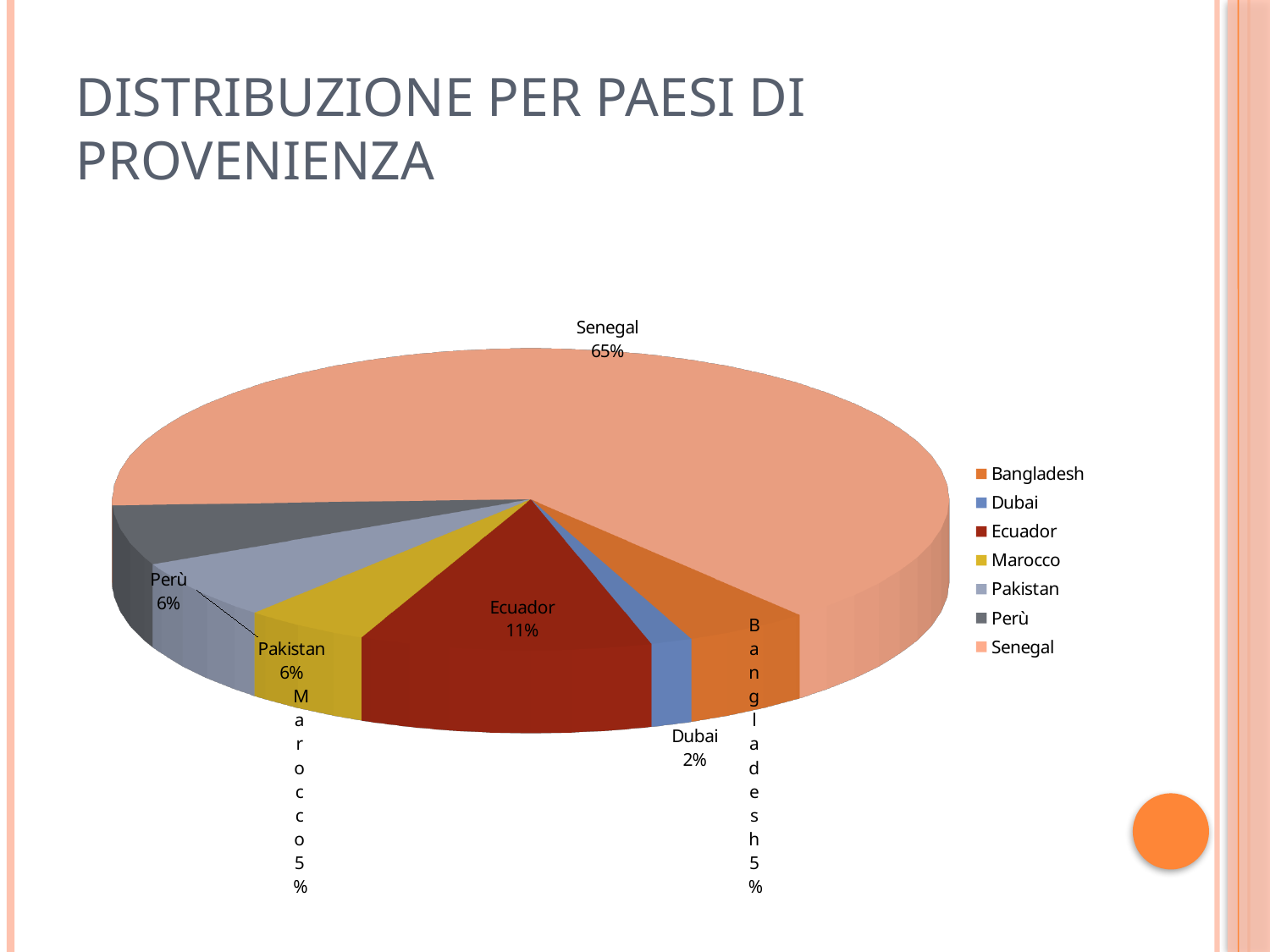
Which country has the largest slice of the pie? Senegal What is the share for Senegal? 65% What is the share for Dubai? 2% Which is larger, the share for Ecuador or the share for Perù? Ecuador What is the share for Ecuador? 11% What is the share for Bangladesh? 5% How many countries are listed in the legend? 7 What is the title of the slide? Distribuzione per paesi di provenienza What kind of chart is shown on the slide? pie chart What is the share for Marocco? 5% What is the difference in percentage points between Senegal and Ecuador? 54 Which country has the smallest slice of the pie? Dubai